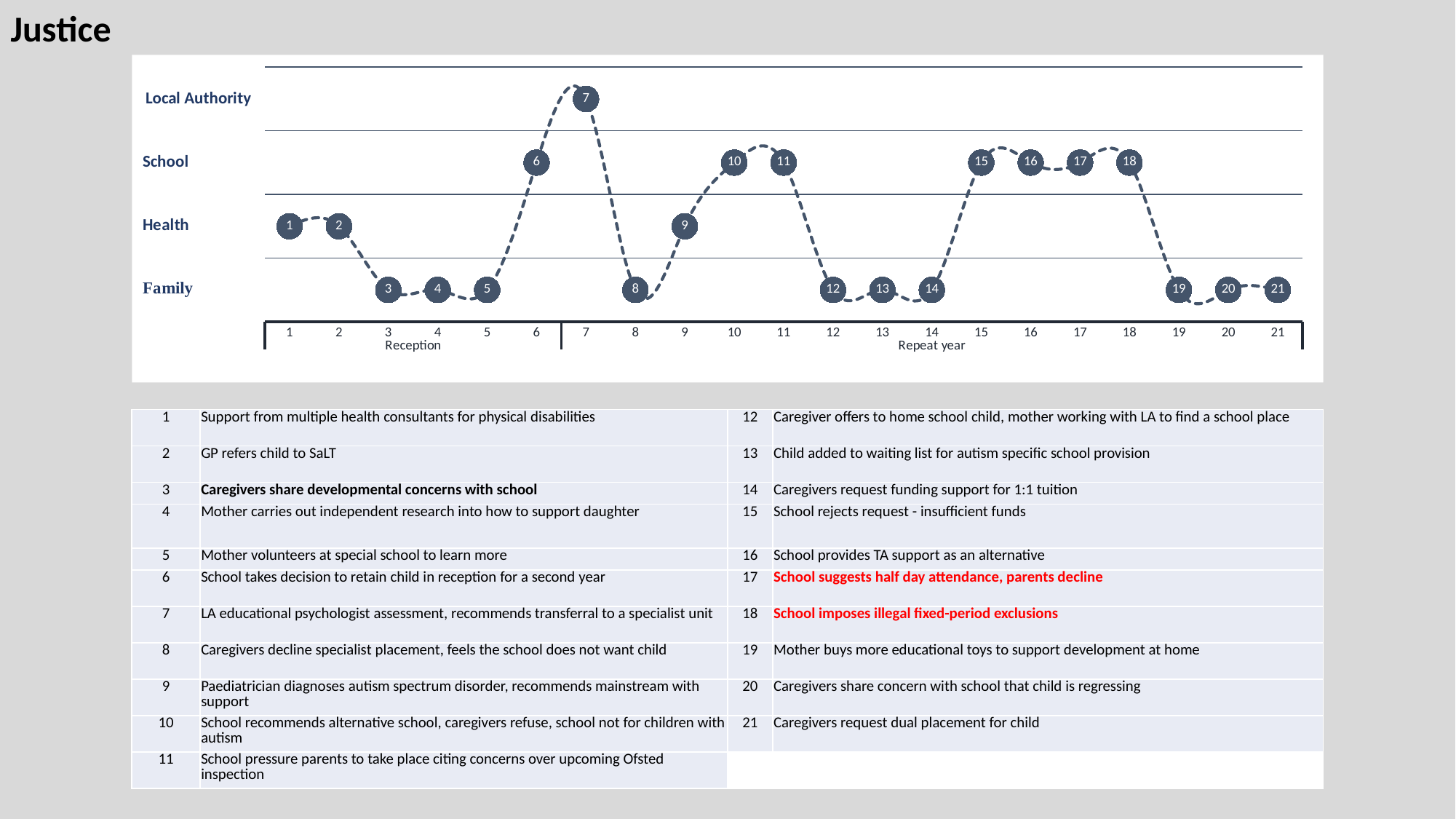
Which vertical-axis category is point 16 plotted on? School How many points are plotted on the Family row? 10 How many points are plotted on the School row? 7 Which is the only point plotted on the Local Authority row? 7 Which vertical-axis category is point 7 plotted on? Local Authority Which vertical-axis category is point 9 plotted on? Health What type of chart is shown on the slide? Line chart How many numbered points are plotted on the chart? 21 What are the two phase labels shown beneath the x axis of the chart? Reception and Repeat year Which vertical-axis category is point 13 plotted on? Family Which points are plotted on the Health row? 1, 2 and 9